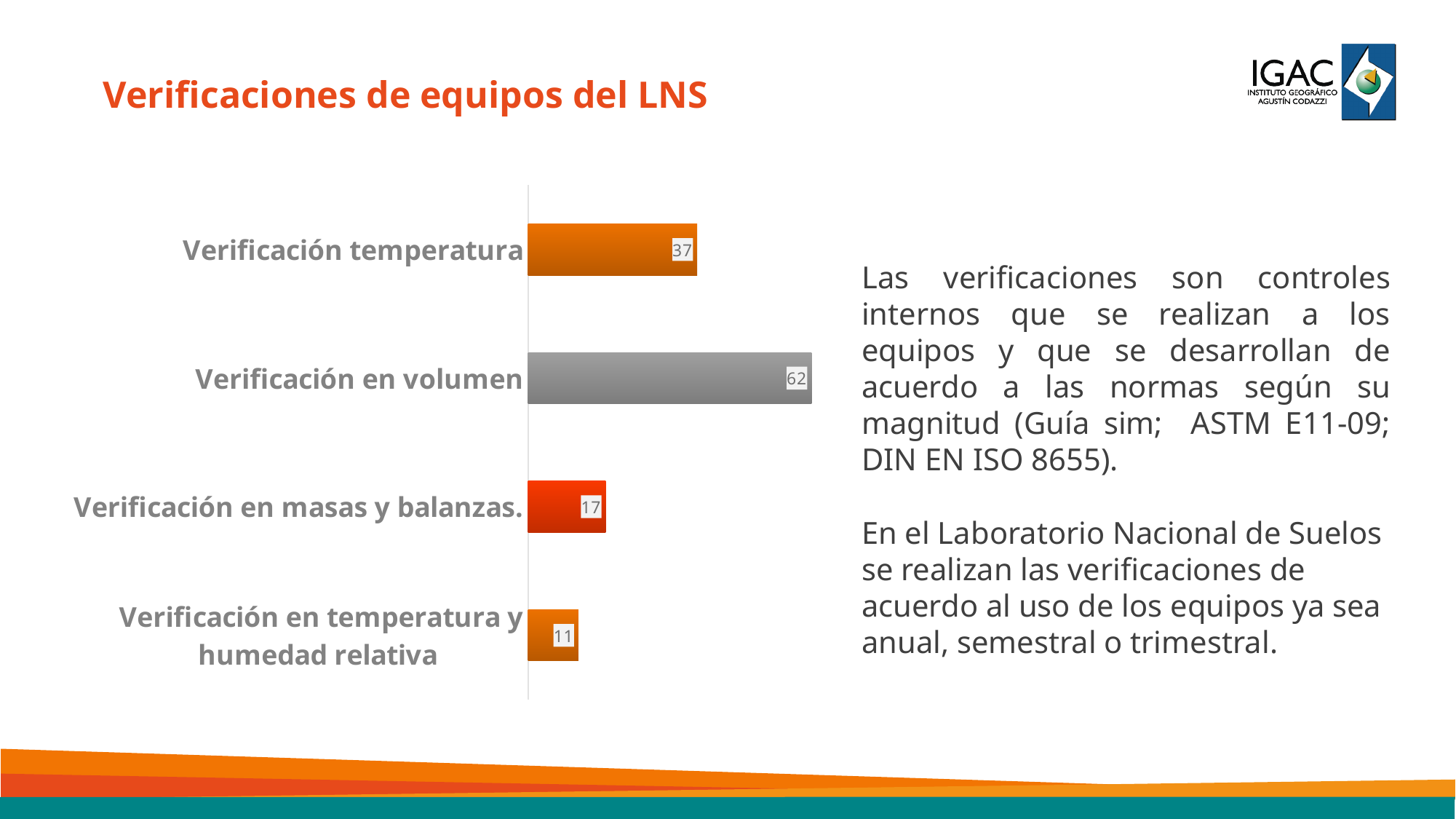
What is the value for Verificación en masas y balanzas? 17 Which category has the lowest value? Verificación en temperatura y humedad relativa What is the value for Verificación temperatura? 37 Which is larger, the value for Verificación temperatura or the value for Verificación en masas y balanzas? Verificación temperatura What is the difference between the values for Verificación en volumen and Verificación temperatura? 25 What colour is the bar for Verificación en volumen? Grey What is the difference between the values for Verificación en masas y balanzas and Verificación en temperatura y humedad relativa? 6 Which category has the highest value? Verificación en volumen What is the value for Verificación en volumen? 62 What kind of chart is shown on the slide? Bar chart What is the value for Verificación en temperatura y humedad relativa? 11 How many categories are shown in the chart? 4